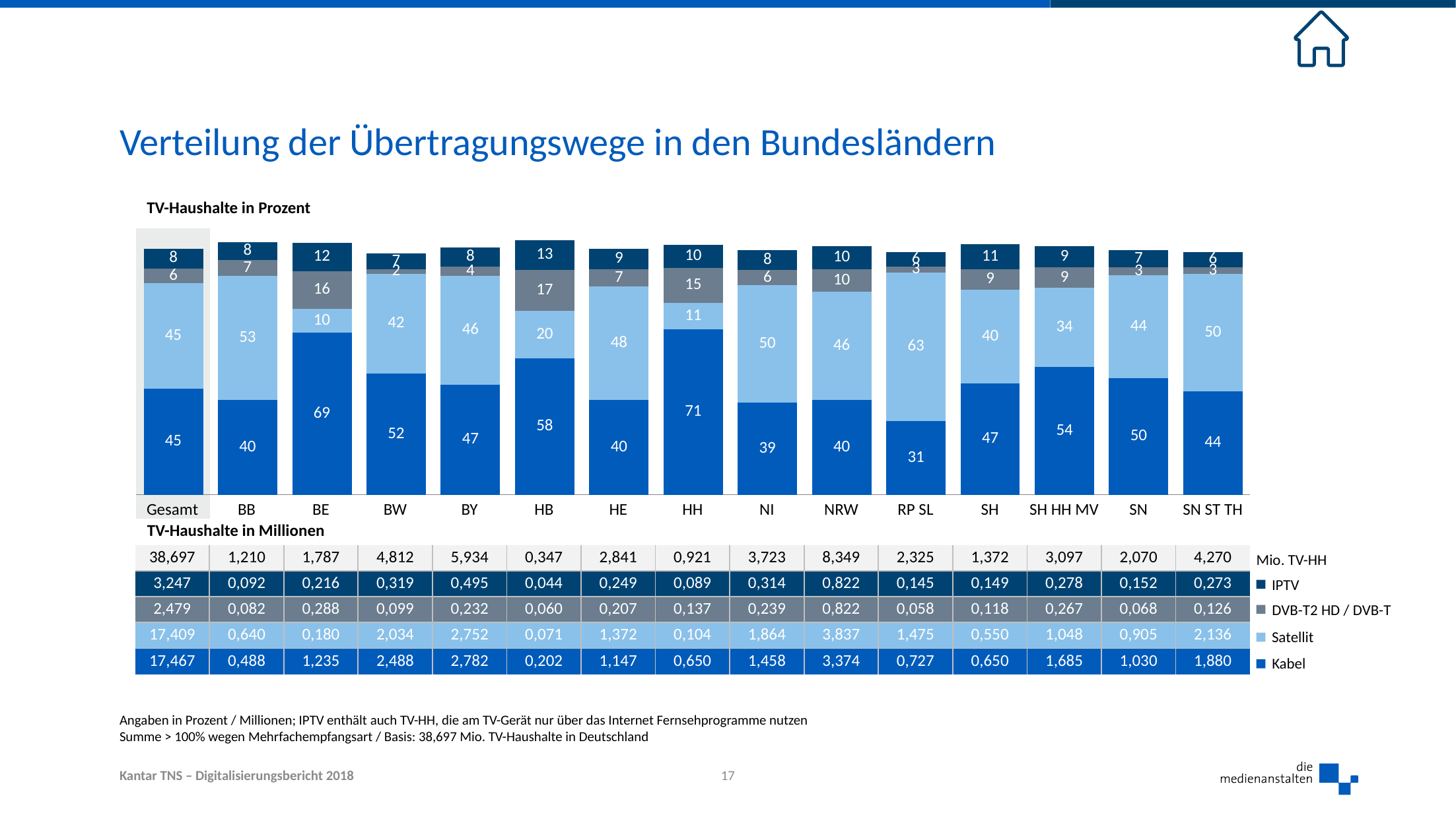
What is the Kabel percentage for HH in the bar chart? 71 In the table "TV-Haushalte in Millionen", what is the Mio. TV-HH value for NRW? 8,349 Which is larger in the bar chart: the DVB-T2 HD / DVB-T percentage for HB or for BE? HB Which category has the lowest Satellit percentage in the bar chart? BE What is the Satellit percentage for RP SL in the bar chart? 63 Which category has the highest Kabel percentage in the bar chart? HH How many categories (Bundesländer plus Gesamt) are shown on the x axis of the bar chart? 15 What is the total of the stacked bar for BE (sum of all four segments)? 107 Which category has the lowest Kabel percentage in the bar chart? RP SL What is the difference between the Kabel percentage for HH and for RP SL? 40 What kind of chart is shown under "TV-Haushalte in Prozent"? stacked bar chart How many series does the legend list for the stacked bars? 4